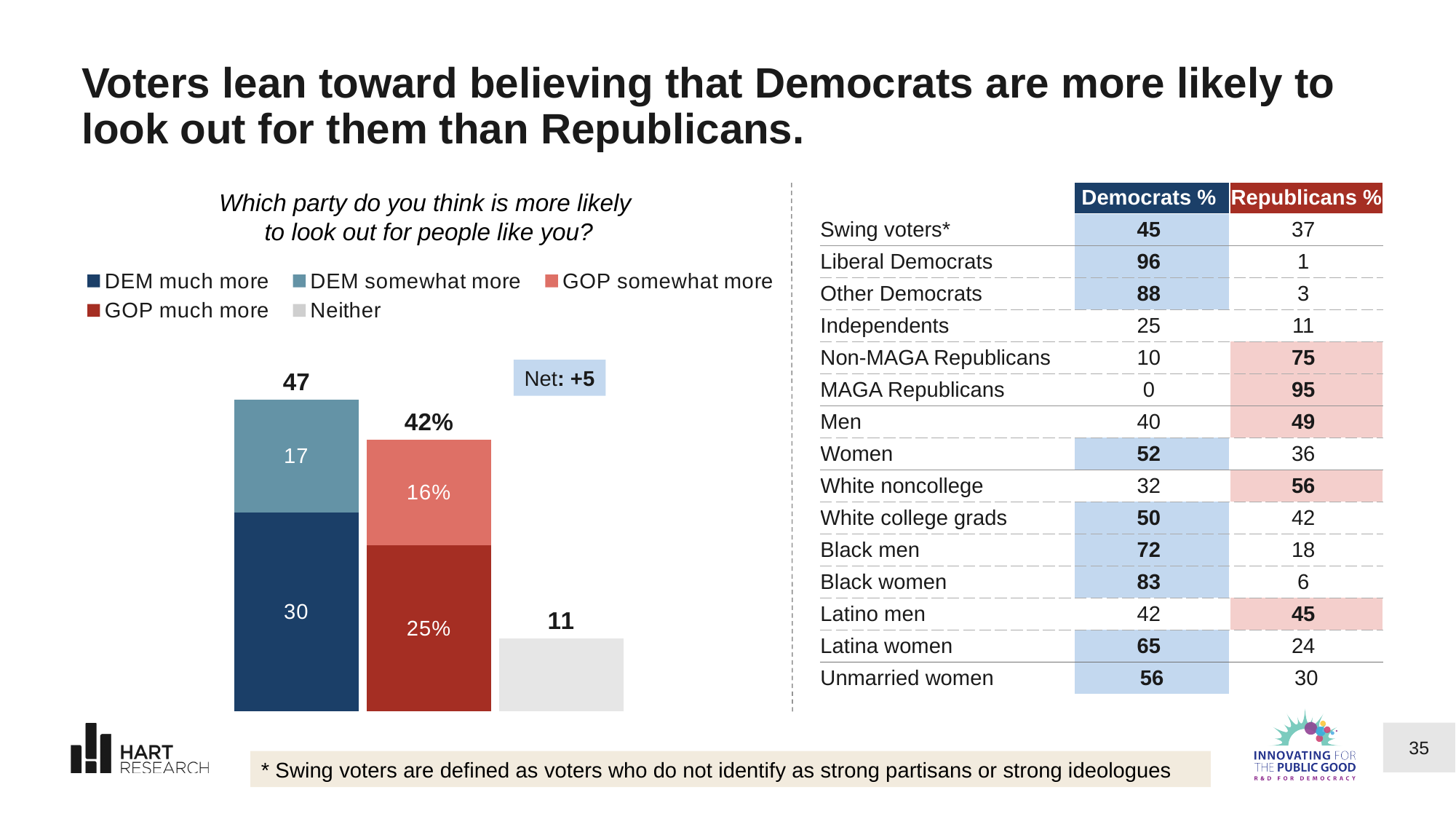
What is the total of the Democrats stacked bar (DEM much more plus DEM somewhat more)? 47 What is the value for GOP somewhat more in the chart? 16% What net value is shown in the box next to the chart? +5 What is the value for GOP much more in the chart? 25% Which is larger in the chart: DEM much more or GOP much more? DEM much more What is the value for DEM much more in the chart? 30 What is the total of the Republicans stacked bar (GOP much more plus GOP somewhat more)? 42% How many series does the chart legend list? 5 What is the difference between the Democrats bar total (47) and the Republicans bar total (42%)? 5 What is the value for DEM somewhat more in the chart? 17 What is the value for Neither in the chart? 11 What type of chart is shown on the left of the slide? Stacked bar chart